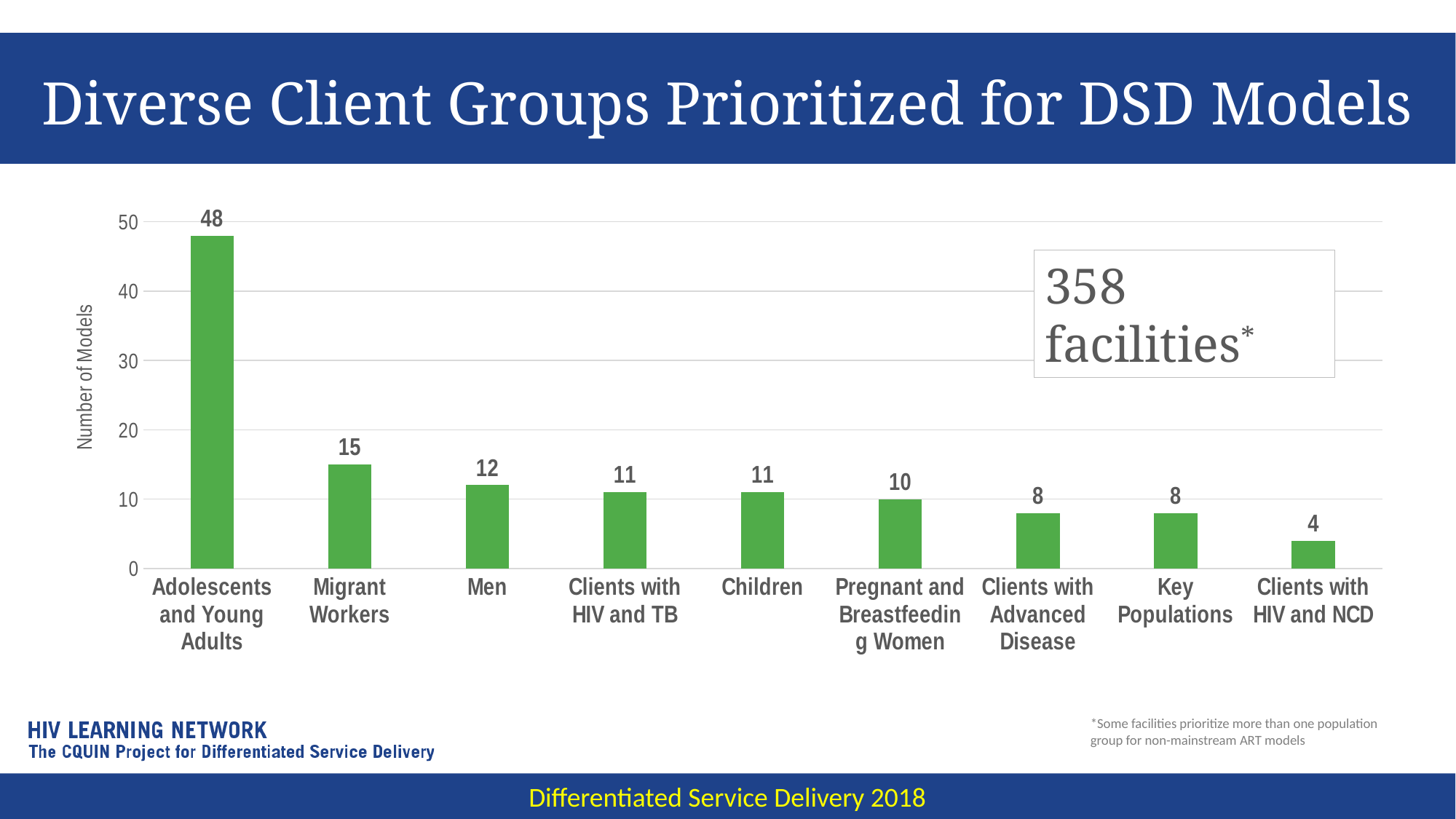
Which client group has the highest number of models? Adolescents and Young Adults Is the value for Pregnant and Breastfeeding Women greater or less than 20? less Which client group has the lowest number of models? Clients with HIV and NCD What is the number of models for Adolescents and Young Adults? 48 What is the label of the y axis? Number of Models What is the number of models for Clients with HIV and NCD? 4 What kind of chart is shown on the slide? bar chart How many client groups are shown in the chart? 9 Which has more models, Men or Children? Men How many facilities does the text box on the chart mention? 358 facilities What is the difference in number of models between Adolescents and Young Adults and Migrant Workers? 33 What is the number of models for Migrant Workers? 15